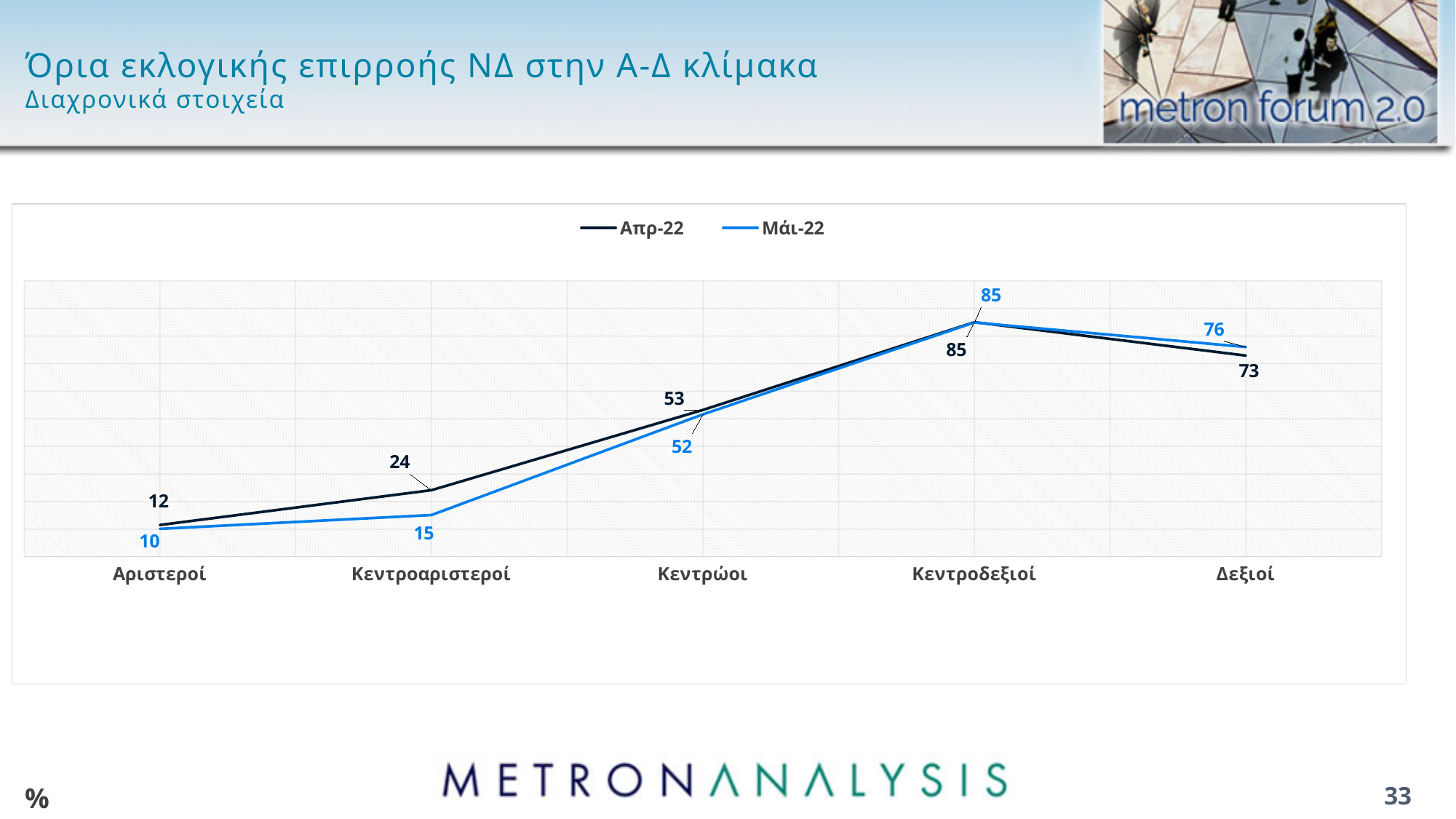
What is the value for Κεντρώοι in the Απρ-22 series? 53 What is the value for Δεξιοί in the Μάι-22 series? 76 Do the Μάι-22 values rise or fall from Αριστεροί to Κεντροδεξιοί? Rise Which category has the highest value in the Απρ-22 series? Κεντροδεξιοί What is the difference between the Απρ-22 and Μάι-22 values for Κεντροαριστεροί? 9 What is the value for Κεντροαριστεροί in the Μάι-22 series? 15 How many categories are shown on the x axis? 5 Which category has the lowest value in the Μάι-22 series? Αριστεροί For Δεξιοί, which series has the larger value, Απρ-22 or Μάι-22? Μάι-22 How many series does the legend list? 2 What colour is the line for the Μάι-22 series? Blue What kind of chart is shown on the slide? Line chart